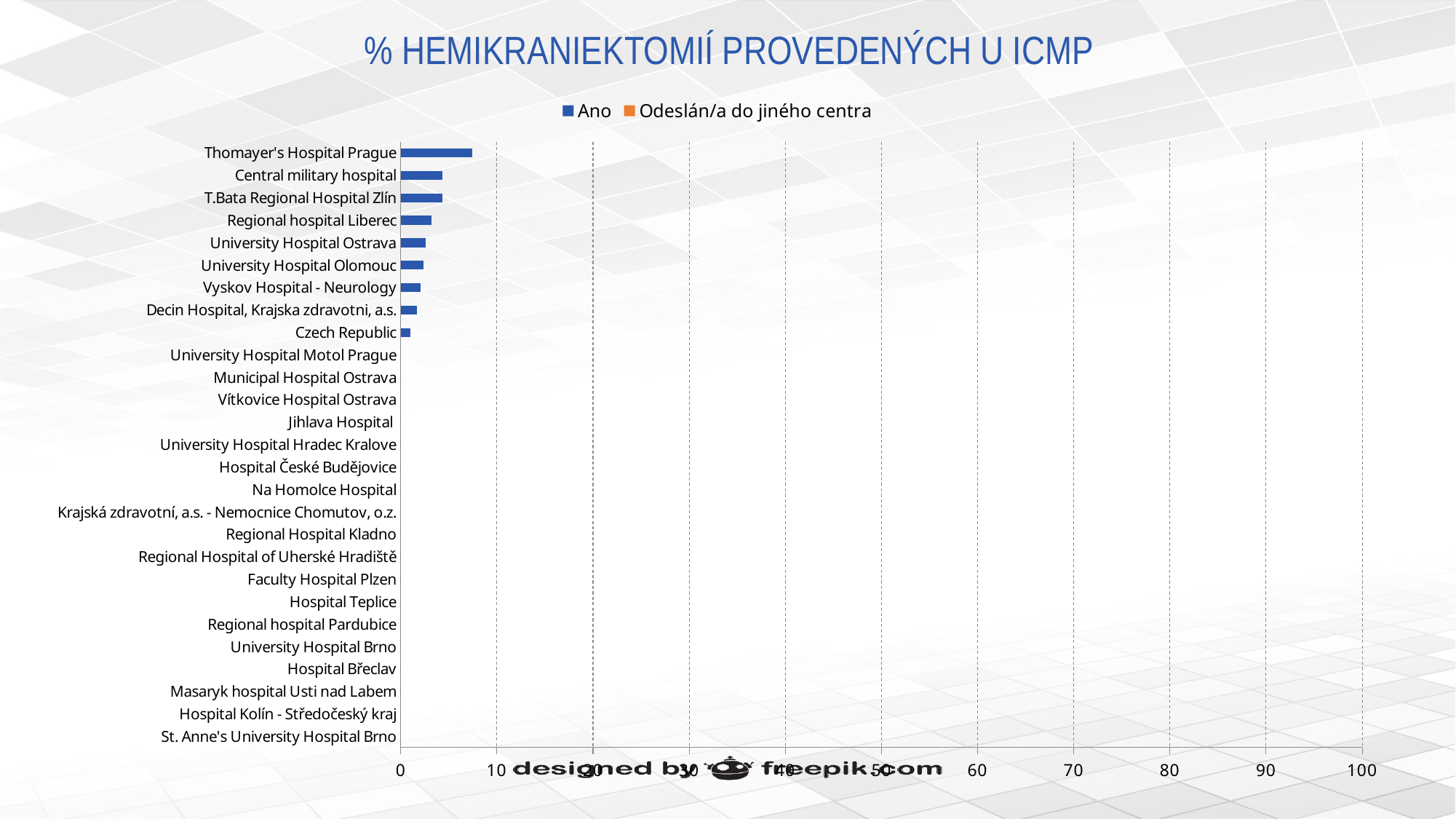
Which has a larger Ano value: Regional hospital Liberec or Czech Republic? Regional hospital Liberec Which has a larger Ano value: University Hospital Ostrava or Decin Hospital, Krajska zdravotni, a.s.? University Hospital Ostrava Which hospital has the highest value for Ano? Thomayer's Hospital Prague How many series does the legend list? 2 Is the Ano value for Czech Republic greater or less than 10? less What are the two series named in the legend? Ano; Odeslán/a do jiného centra Is the Ano value for Central military hospital greater or less than 10? less Is the Ano value for Thomayer's Hospital Prague greater or less than 10? less How many hospitals (categories) are listed on the vertical axis? 27 What is the title of the chart? % HEMIKRANIEKTOMIÍ PROVEDENÝCH U ICMP Which has a larger Ano value: Thomayer's Hospital Prague or Central military hospital? Thomayer's Hospital Prague What kind of chart is shown on the slide? bar chart